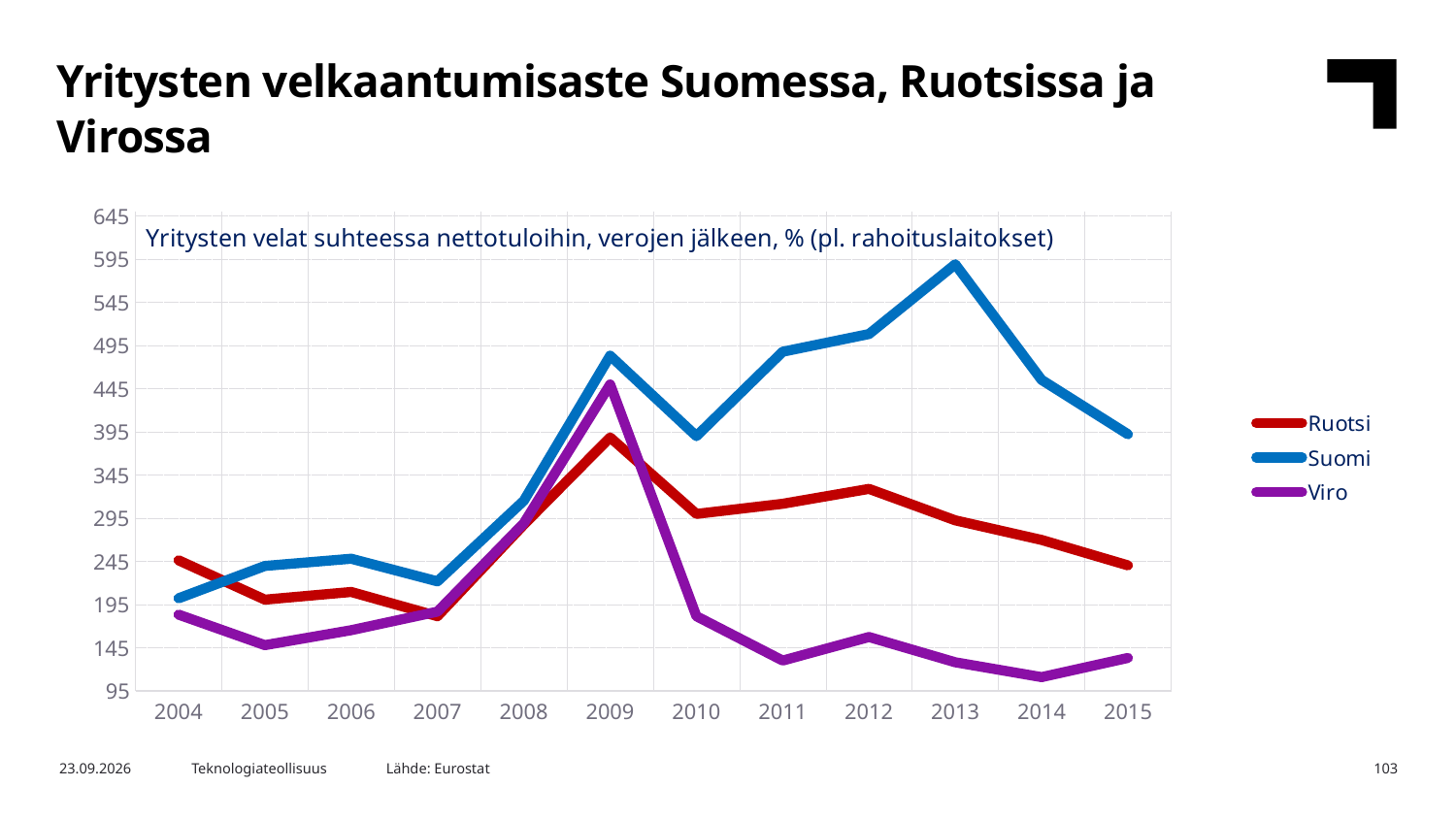
How many years are shown on the x axis? 12 Which series is shown in purple in the legend? Viro Is the value for Ruotsi in 2012 greater or less than 295? greater Which is larger in 2004, the value for Ruotsi or the value for Suomi? Ruotsi In which year does the Viro line reach its lowest value? 2014 What kind of chart is shown on the slide? line chart Which series has the highest value in 2013? Suomi Is the value for Viro in 2014 greater or less than 145? less Does the Suomi line rise or fall from 2013 to 2015? fall In which year does the Suomi line reach its highest value? 2013 How many series does the legend list? 3 Is the value for Suomi in 2013 greater or less than 545? greater